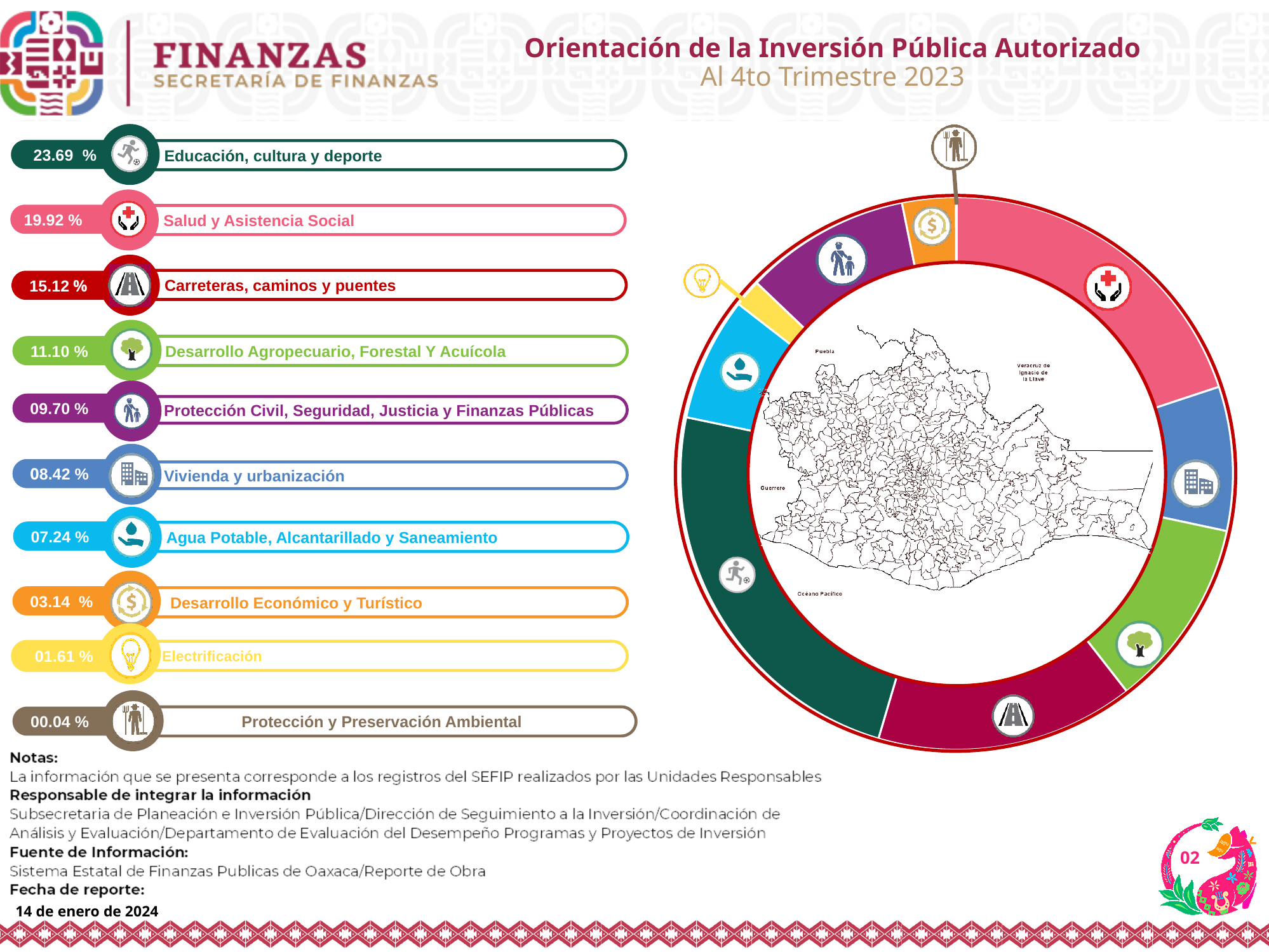
What percentage is shown for Educación, cultura y deporte? 23.69 % What percentage is shown for Salud y Asistencia Social? 19.92 % Which has a larger percentage, Vivienda y urbanización or Agua Potable, Alcantarillado y Saneamiento? Vivienda y urbanización Which category has the lowest percentage? Protección y Preservación Ambiental What kind of chart is shown on the right of the slide? Pie (donut) chart What percentage is shown for Agua Potable, Alcantarillado y Saneamiento? 07.24 % How many categories are listed on the slide? 10 Which category has the highest percentage? Educación, cultura y deporte What is the title of the slide? Orientación de la Inversión Pública Autorizado Al 4to Trimestre 2023 What percentage is shown for Carreteras, caminos y puentes? 15.12 % What percentage is shown for Electrificación? 01.61 % What is the difference in percentage points between Educación, cultura y deporte and Salud y Asistencia Social? 3.77